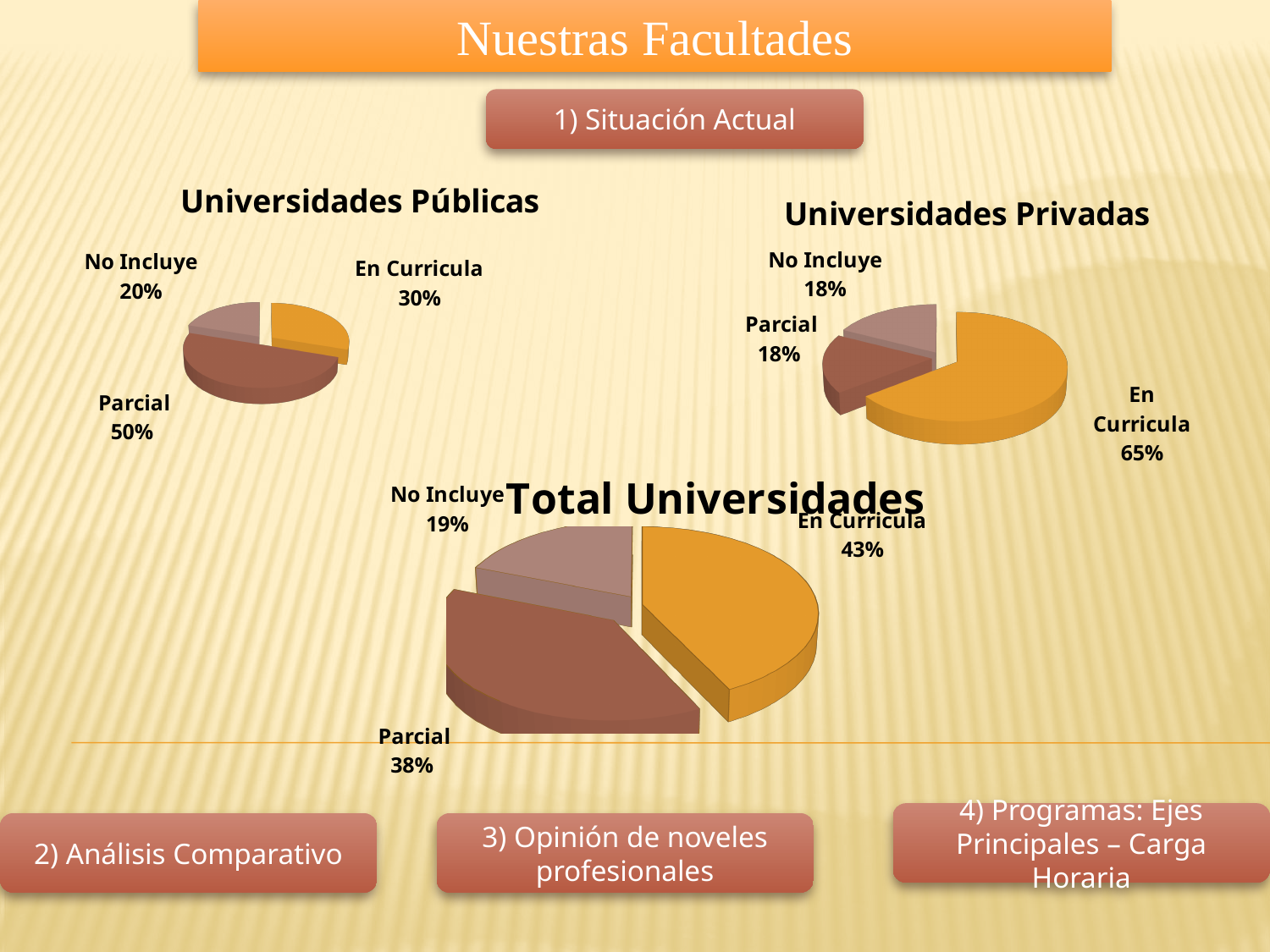
In the 'Total Universidades' chart, which category has the largest slice? En Curricula In the 'Universidades Privadas' chart, what percentage is labelled for 'En Curricula'? 65% How many charts are shown on the slide? 3 In the 'Universidades Públicas' chart, what percentage is labelled for 'En Curricula'? 30% In the 'Universidades Públicas' chart, what percentage is labelled for 'Parcial'? 50% In the 'Total Universidades' chart, which is larger, 'En Curricula' or 'No Incluye'? En Curricula In the 'Universidades Públicas' chart, which category has the smallest slice? No Incluye What type of chart is 'Total Universidades'? Pie chart In the 'Total Universidades' chart, what percentage is labelled for 'Parcial'? 38% In the 'Universidades Privadas' chart, what percentage is labelled for 'No Incluye'? 18% In the 'Universidades Privadas' chart, what is the difference between the 'En Curricula' and 'Parcial' percentages? 47% How many slices does the 'Universidades Privadas' chart have? 3